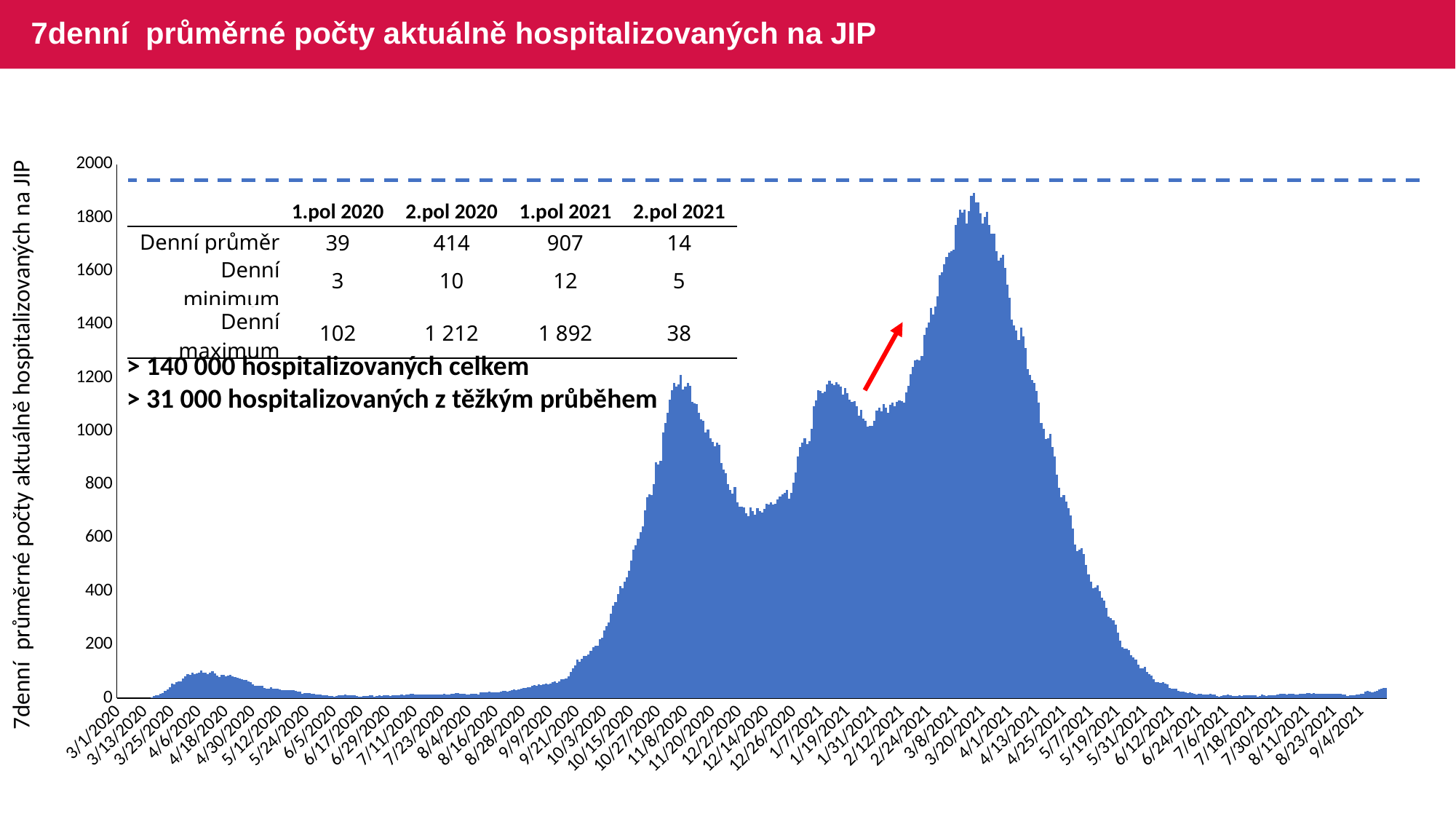
What is the title of the slide above the chart? 7denní průměrné počty aktuálně hospitalizovaných na JIP Is the value for 4/6/2020 greater or less than 200? less Is the value for 3/8/2021 greater or less than 1600? greater Which is larger, the value for 11/8/2020 or the value for 12/14/2020? 11/8/2020 Is the value for 7/6/2021 greater or less than 200? less Do the values rise or fall between 9/21/2020 and 11/8/2020? rise Do the values rise or fall between 3/20/2021 and 5/19/2021? fall According to the table on the chart, which half-year has the highest daily average (Denní průměr)? 1.pol 2021 What is the highest value shown on the vertical axis of the chart? 2000 What kind of chart is shown on the slide? bar chart According to the table on the chart, what is the daily maximum (Denní maximum) for 1.pol 2021? 1 892